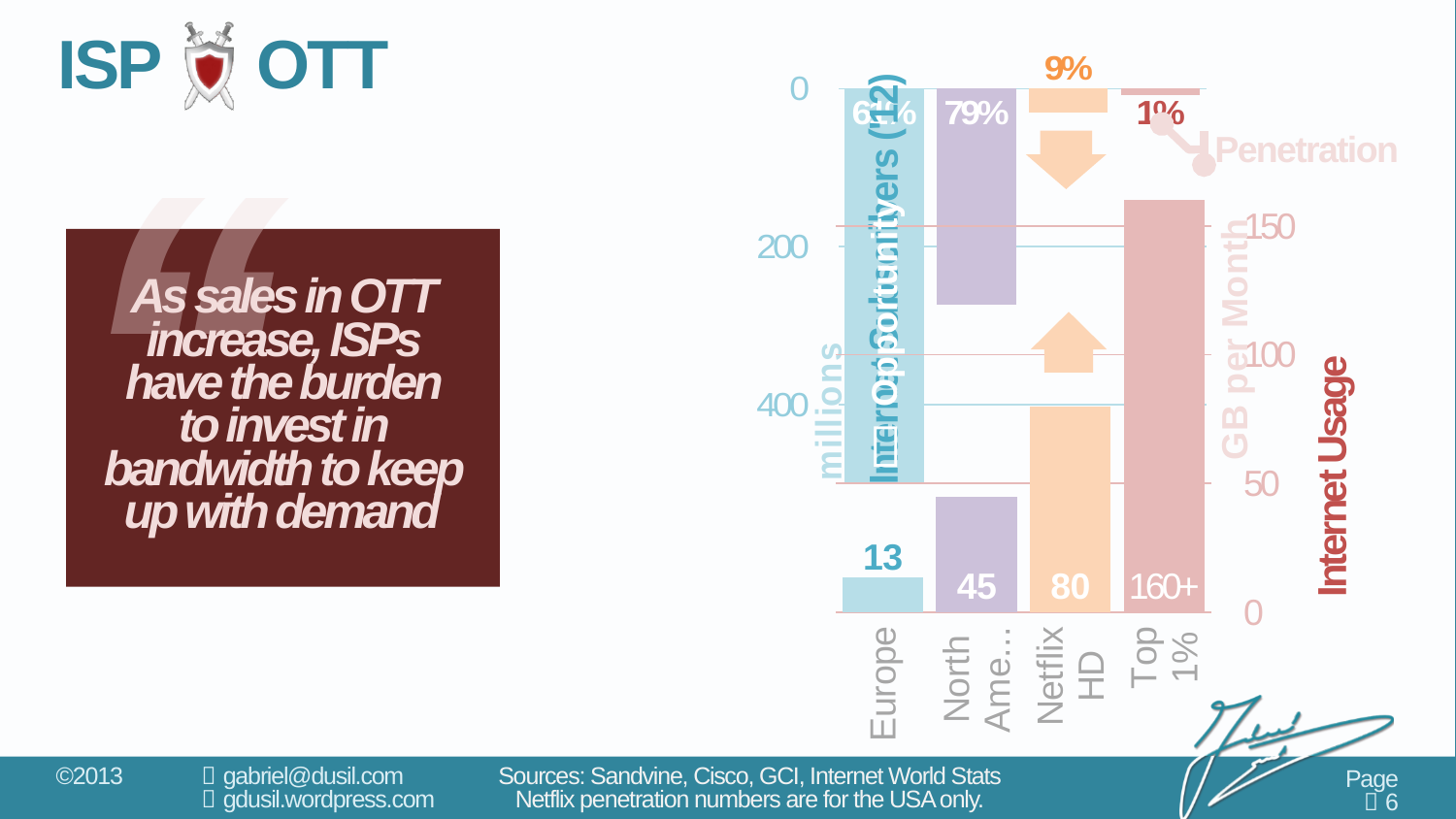
What is the Penetration value for North America? 79% What is the Internet Usage value for the Top 1%? 160+ What is the Internet Usage value for Netflix HD? 80 What is the Internet Usage value for North America? 45 What is the Penetration value for Netflix HD? 9% How many categories are shown on the x axis of the chart? 4 What is the Internet Usage value for Europe? 13 What kind of chart is shown on the slide? Bar chart Which category has the highest Internet Usage? Top 1% What is the difference in Internet Usage between Netflix HD and North America? 35 Which has the higher Penetration, North America or Netflix HD? North America Which category has the lowest Internet Usage? Europe